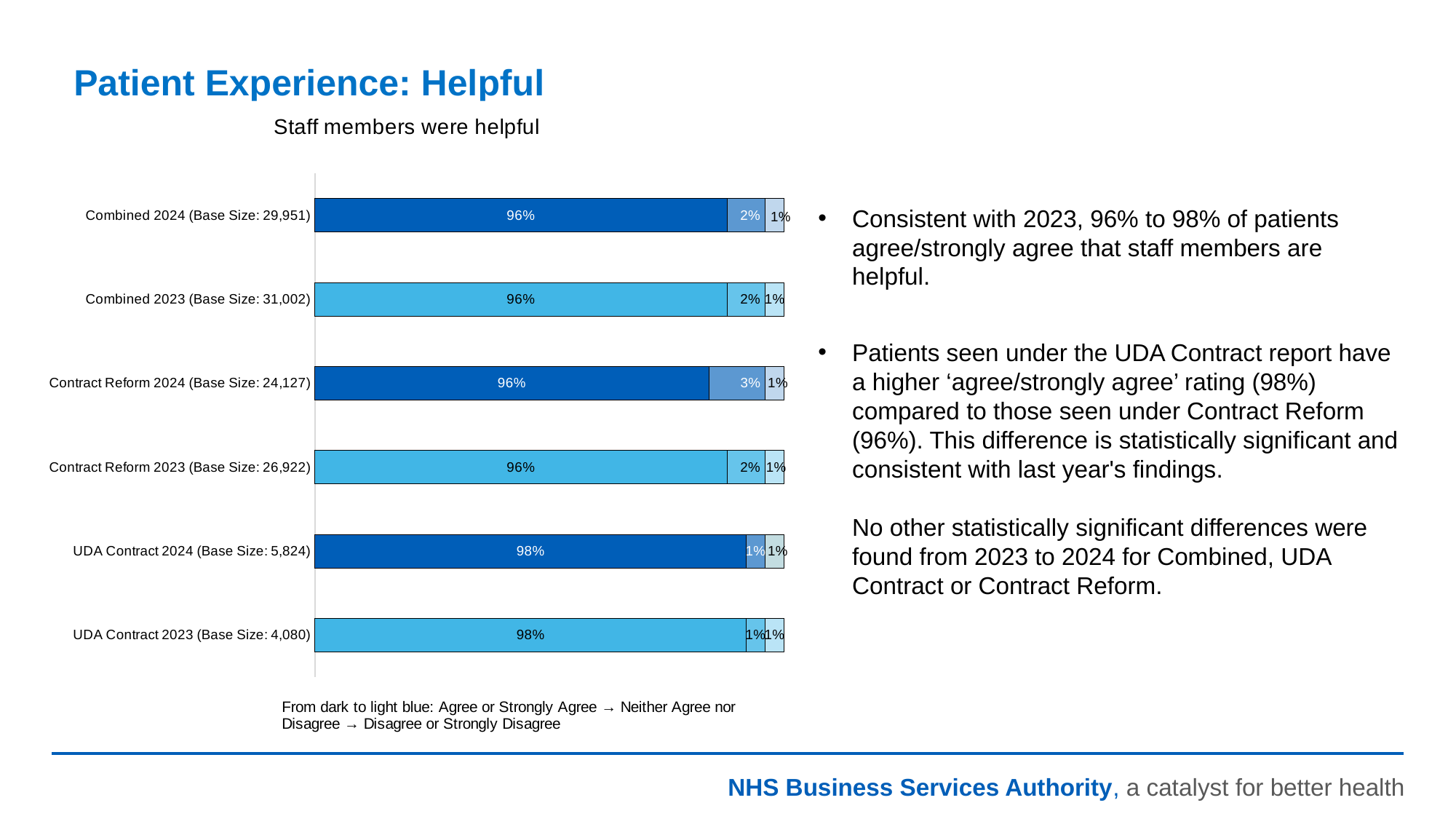
What is the 'Agree or Strongly Agree' value for UDA Contract 2024? 98% Which has a larger 'Agree or Strongly Agree' value: UDA Contract 2023 or Combined 2023? UDA Contract 2023 How many categories (bars) are shown in the chart? 6 What is the 'Neither Agree nor Disagree' value for Contract Reform 2024? 3% What is the title of the chart? Staff members were helpful What percentage of patients agreed or strongly agreed that staff members were helpful for Combined 2024? 96% What is the difference between the 'Agree or Strongly Agree' values for UDA Contract 2024 and Contract Reform 2024? 2% What is the total of the three segments in the Contract Reform 2024 bar? 100% What is the base size shown for Combined 2024? 29,951 Which category has the highest 'Neither Agree nor Disagree' value? Contract Reform 2024 What kind of chart is shown on the slide? Stacked bar chart What is the 'Disagree or Strongly Disagree' value for Combined 2023? 1%